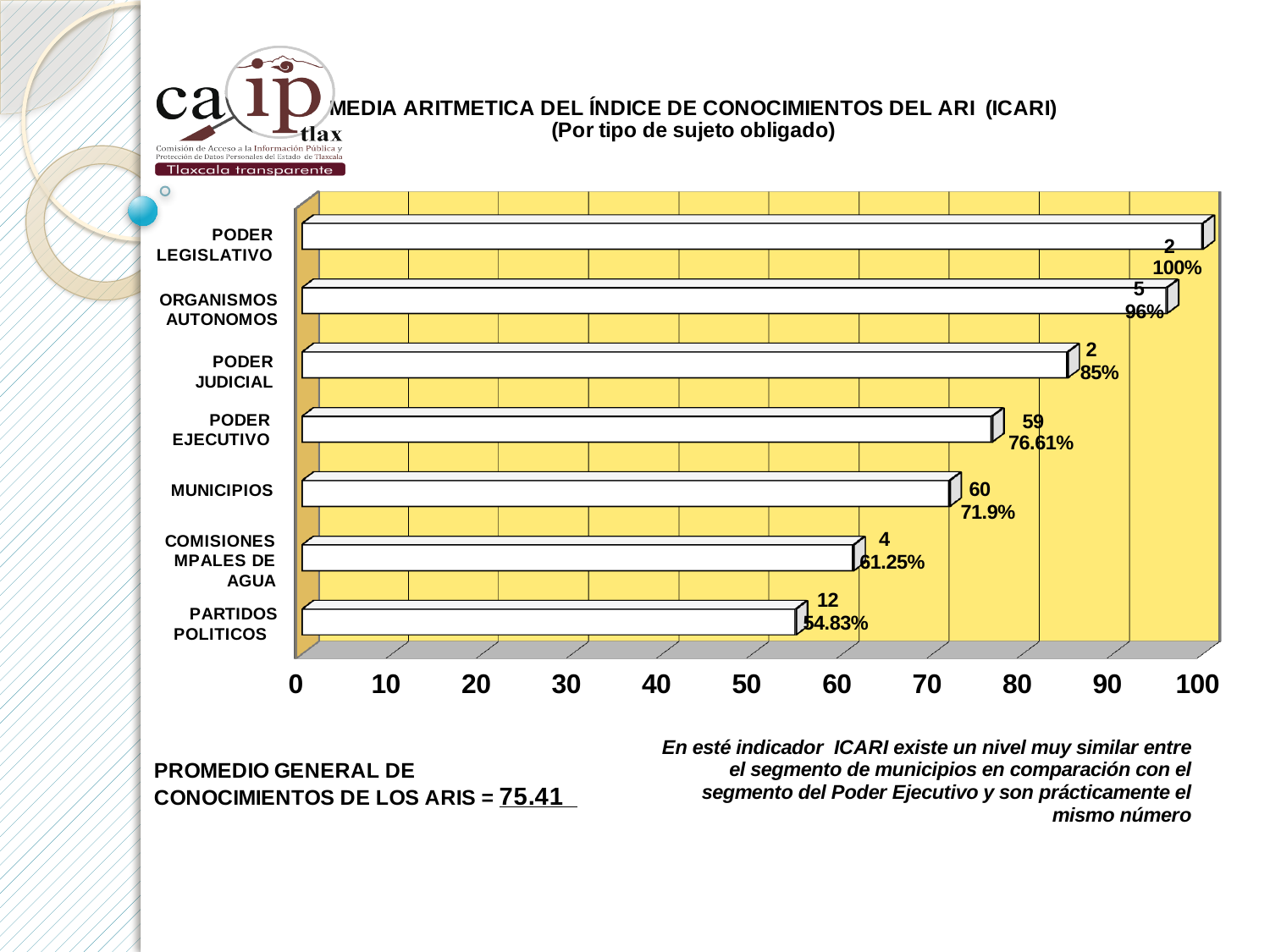
How many categories are shown in the chart? 7 What is the title of the chart? MEDIA ARITMETICA DEL ÍNDICE DE CONOCIMIENTOS DEL ARI (ICARI) (Por tipo de sujeto obligado) What is the difference in percentage between PODER EJECUTIVO and MUNICIPIOS? 4.71% What percentage is shown for PARTIDOS POLITICOS? 54.83% Which has a higher percentage, PODER JUDICIAL or COMISIONES MPALES DE AGUA? PODER JUDICIAL Is the value for ORGANISMOS AUTONOMOS greater or less than 90? greater What kind of chart is shown on the slide? Bar chart What number is printed next to the bar for PODER EJECUTIVO? 59 Which category has the highest percentage? PODER LEGISLATIVO What percentage is shown for PODER LEGISLATIVO? 100% Which category has the lowest percentage? PARTIDOS POLITICOS What percentage is shown for MUNICIPIOS? 71.9%